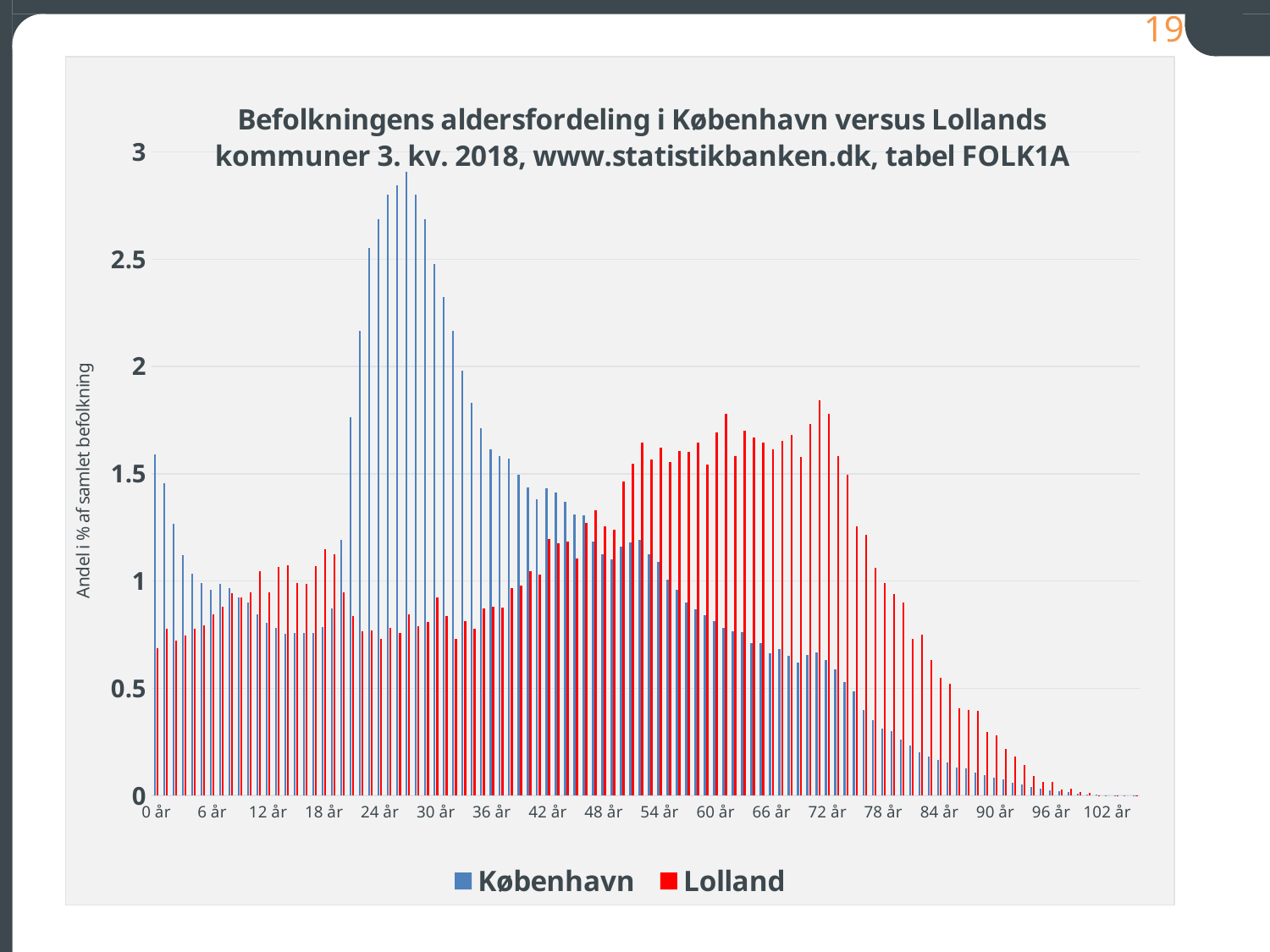
Which series reaches the highest value anywhere on the chart? København What kind of chart is shown on the slide? Bar chart Is the value for København at 0 år greater or less than 1.5? greater At 24 år, which series has the larger value, København or Lolland? København Is the value for Lolland at 24 år greater or less than 1? less Is the value for København at 24 år greater or less than 2? greater At 72 år, which series has the larger value, København or Lolland? Lolland What is the label on the vertical axis? Andel i % af samlet befolkning Which two series are listed in the legend? København and Lolland How many series does the legend list? 2